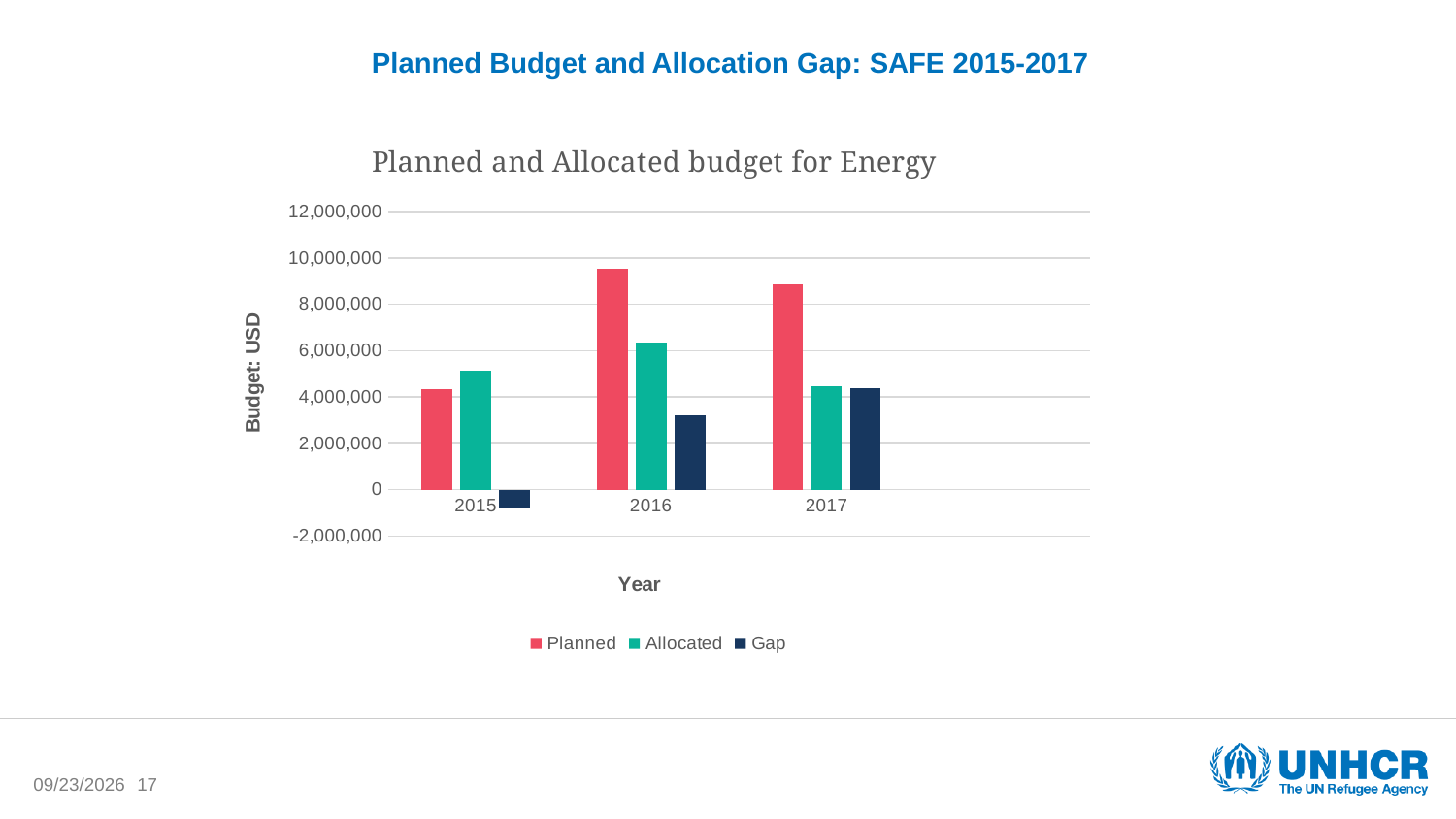
What kind of chart is shown on the slide? Bar chart Is the Allocated budget for 2017 greater or less than 6,000,000? less Is the Gap value for 2015 greater or less than 0? less Which year has the highest Allocated budget? 2016 What is the title of the chart? Planned and Allocated budget for Energy In 2015, which is larger: the Planned budget or the Allocated budget? Allocated How many years are shown on the x axis? 3 Does the Gap value rise or fall from 2015 to 2017? Rise How many series does the legend list? 3 Which year has the lowest Planned budget? 2015 Which year has the highest Planned budget? 2016 Is the Planned budget for 2016 greater or less than 8,000,000? greater